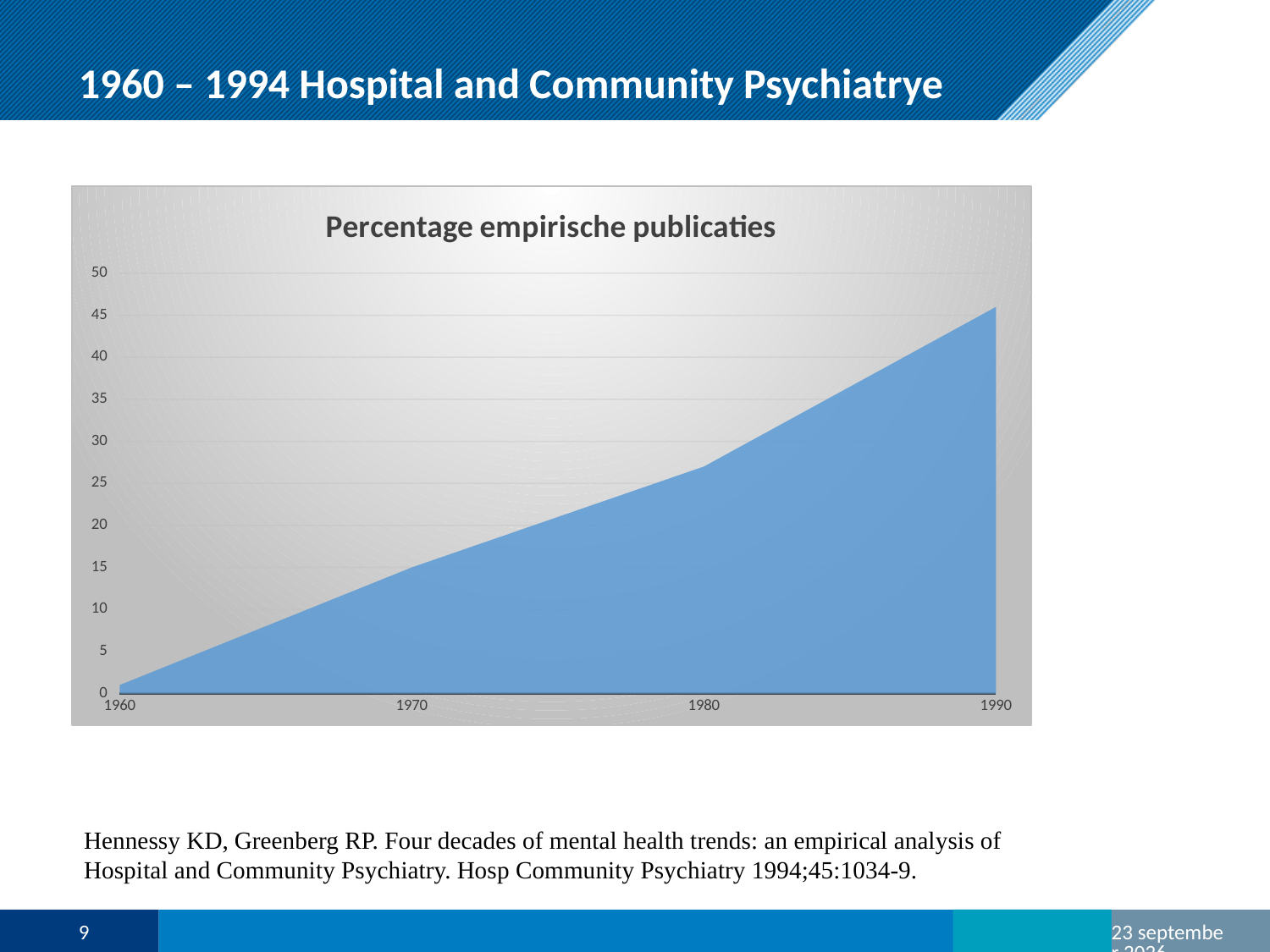
How many years are marked on the x axis of the chart? 4 Is the value for 1970 greater or less than 10? greater Which year has the highest value in the chart? 1990 Do the values rise or fall from 1960 to 1990? rise Which is larger, the value for 1970 or the value for 1980? 1980 Which year has the lowest value in the chart? 1960 Is the value for 1980 greater or less than 20? greater What is the title of the chart? Percentage empirische publicaties Is the value for 1980 greater or less than 35? less What kind of chart is shown on the slide? area chart